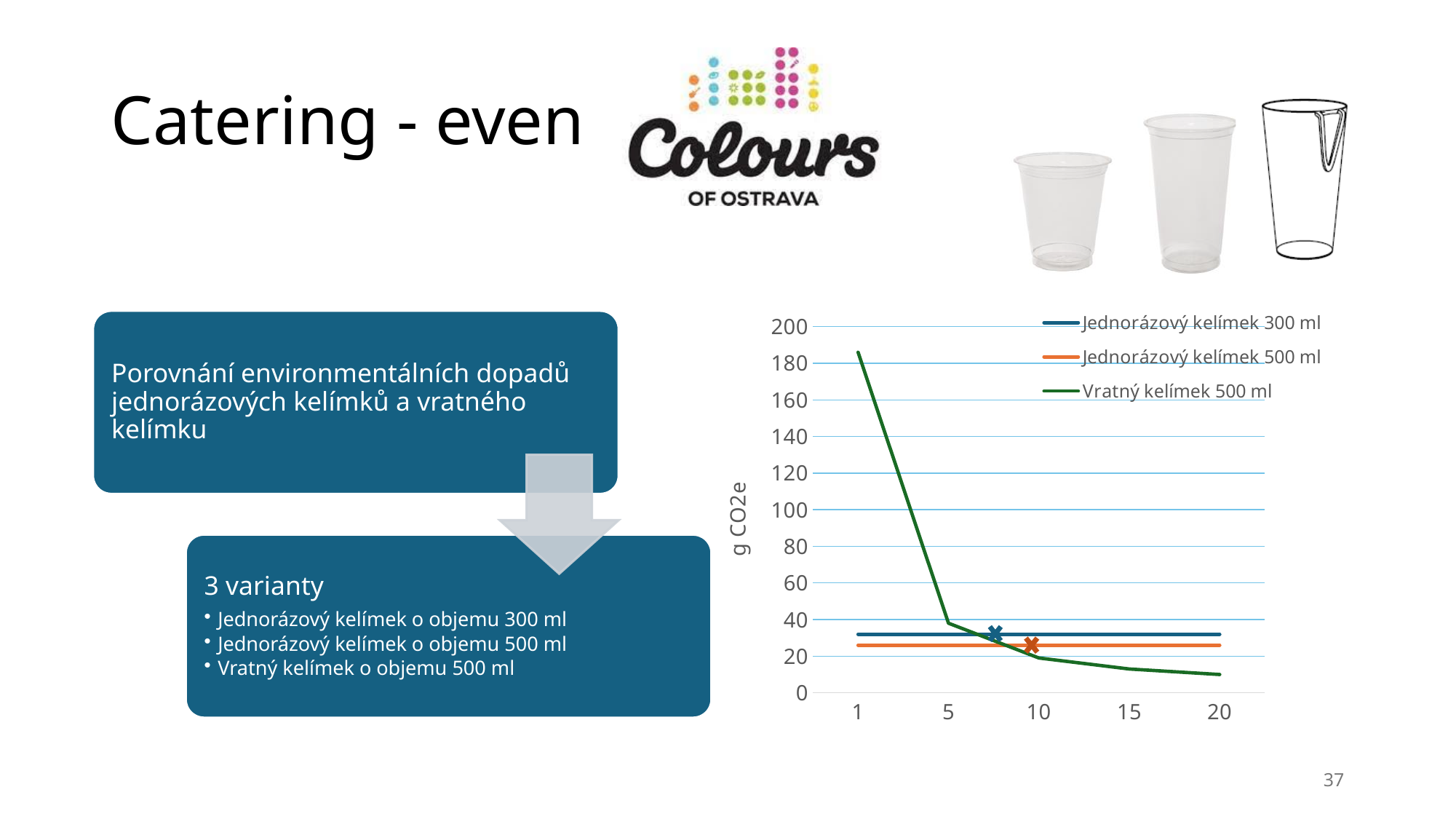
How many series does the chart legend list? 3 Is the value for Jednorázový kelímek 300 ml greater or less than 40? less Which series has the highest value at x = 1? Vratný kelímek 500 ml How many tick labels are shown on the x axis of the chart? 5 Is the value for Jednorázový kelímek 500 ml greater or less than 20? greater Which series has the lowest value at x = 20? Vratný kelímek 500 ml Does the value for Vratný kelímek 500 ml rise or fall as the x axis goes from 1 to 20? fall Is the value for Vratný kelímek 500 ml at x = 20 greater or less than 20? less Which is larger, the value for Jednorázový kelímek 300 ml or the value for Jednorázový kelímek 500 ml? Jednorázový kelímek 300 ml What is the label on the y axis of the chart? g CO2e What kind of chart is shown on the slide? line chart